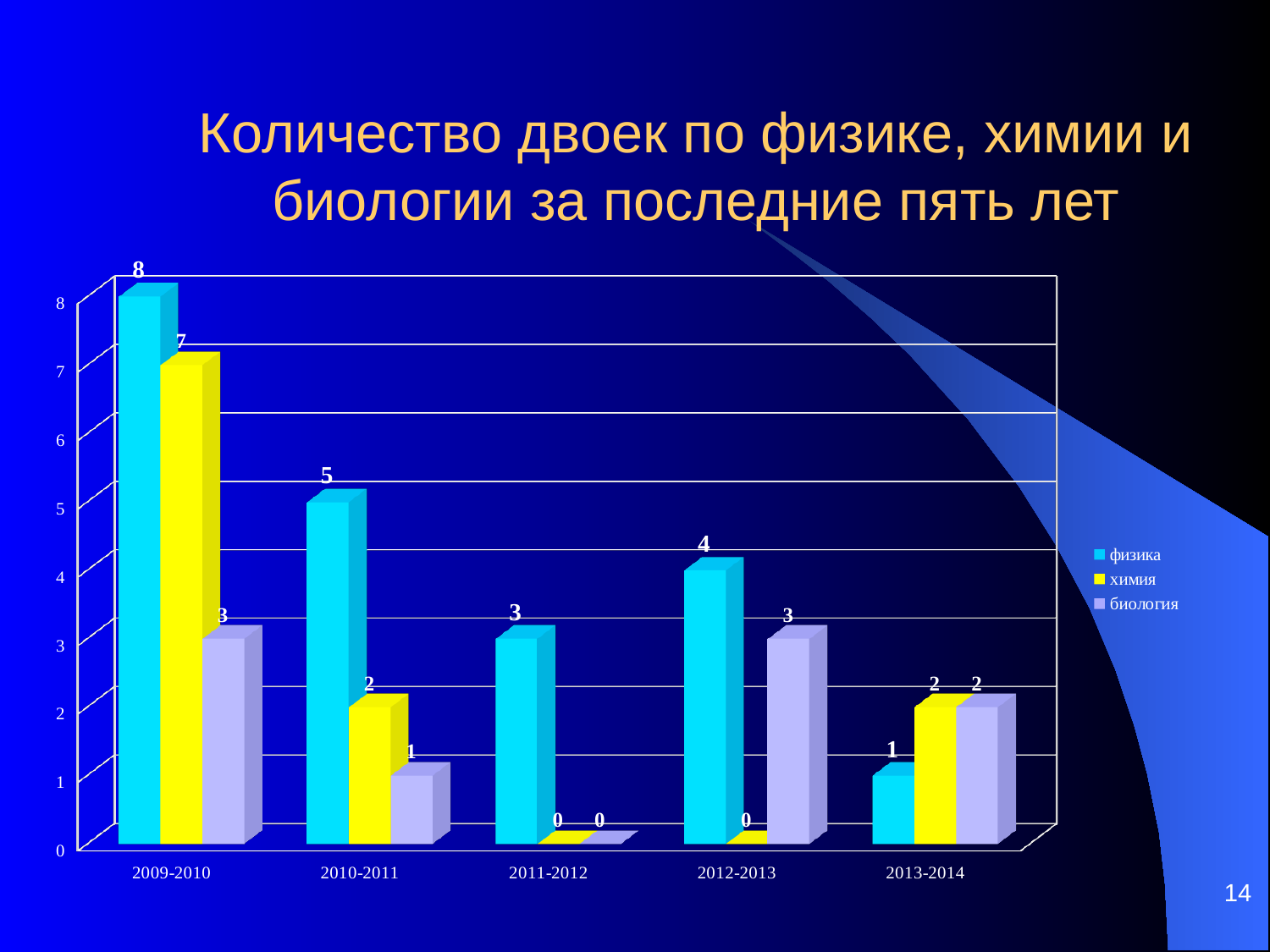
How many series does the legend list? 3 What is the value for физика in 2013-2014? 1 What is the difference between физика and химия in 2009-2010? 1 What type of chart is shown on the slide? bar chart In which school year is the value for физика highest? 2009-2010 What is the value for химия in 2010-2011? 2 Which series is shown in yellow in the legend? химия How many school-year categories are shown on the x axis? 5 In which school year is the value for физика lowest? 2013-2014 What is the value for биология in 2012-2013? 3 Which is larger in 2012-2013: физика or биология? физика What is the value for физика in 2009-2010? 8